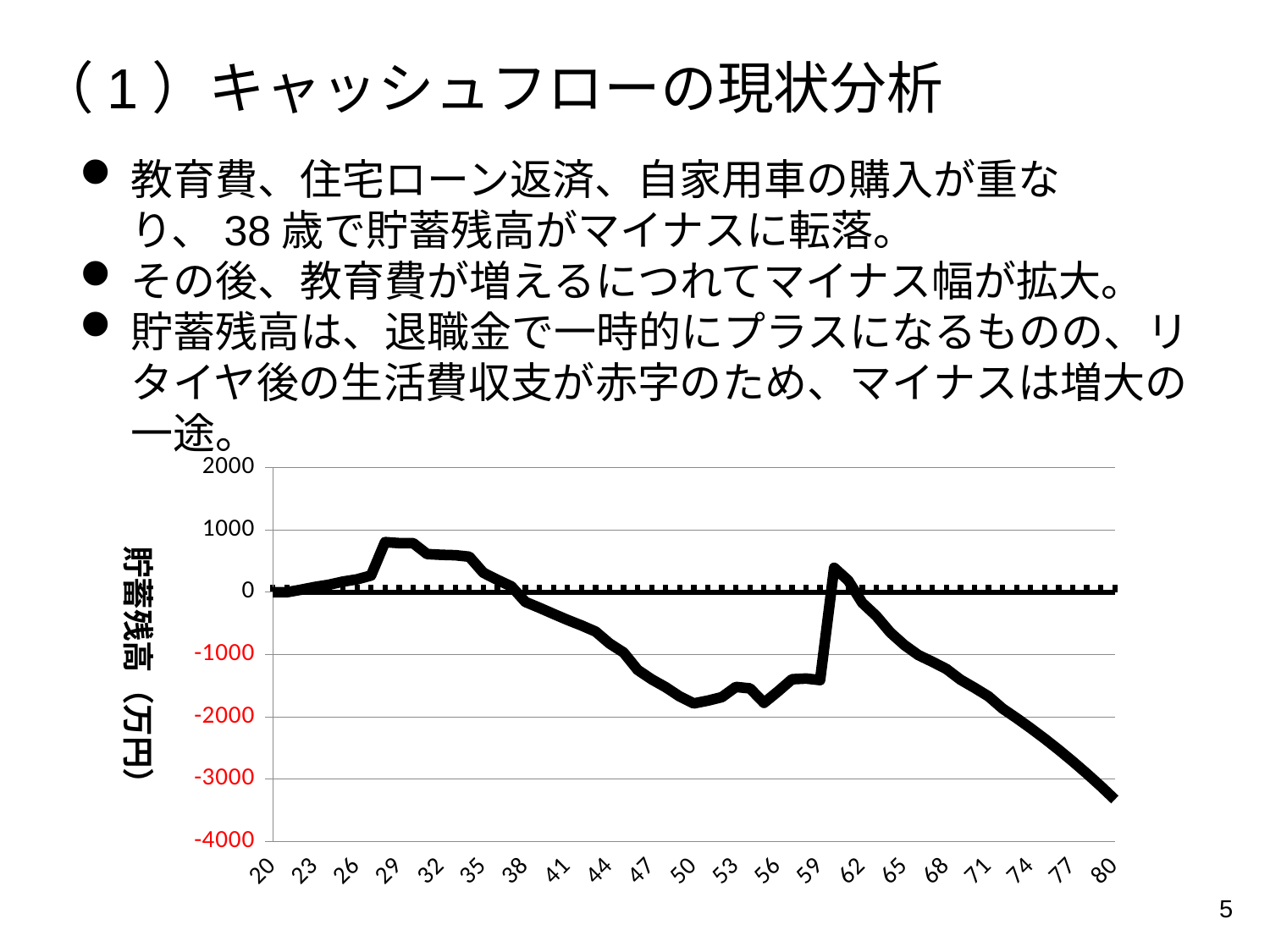
Is the savings balance at age 80 greater or less than -3000? less Is the savings balance at age 59 greater or less than -2000? greater How many age labels are shown along the x axis of the chart? 21 Is the savings balance at age 29 greater or less than 0? greater What kind of chart is shown on the slide? line chart At which age label on the x axis is the savings balance (貯蓄残高) lowest? 80 What is the title of the vertical axis of the chart? 貯蓄残高（万円） Does the savings balance rise or fall from age 20 to age 29? rise Which is larger, the savings balance at age 29 or at age 80? age 29 Does the savings balance rise or fall from age 62 to age 80? fall